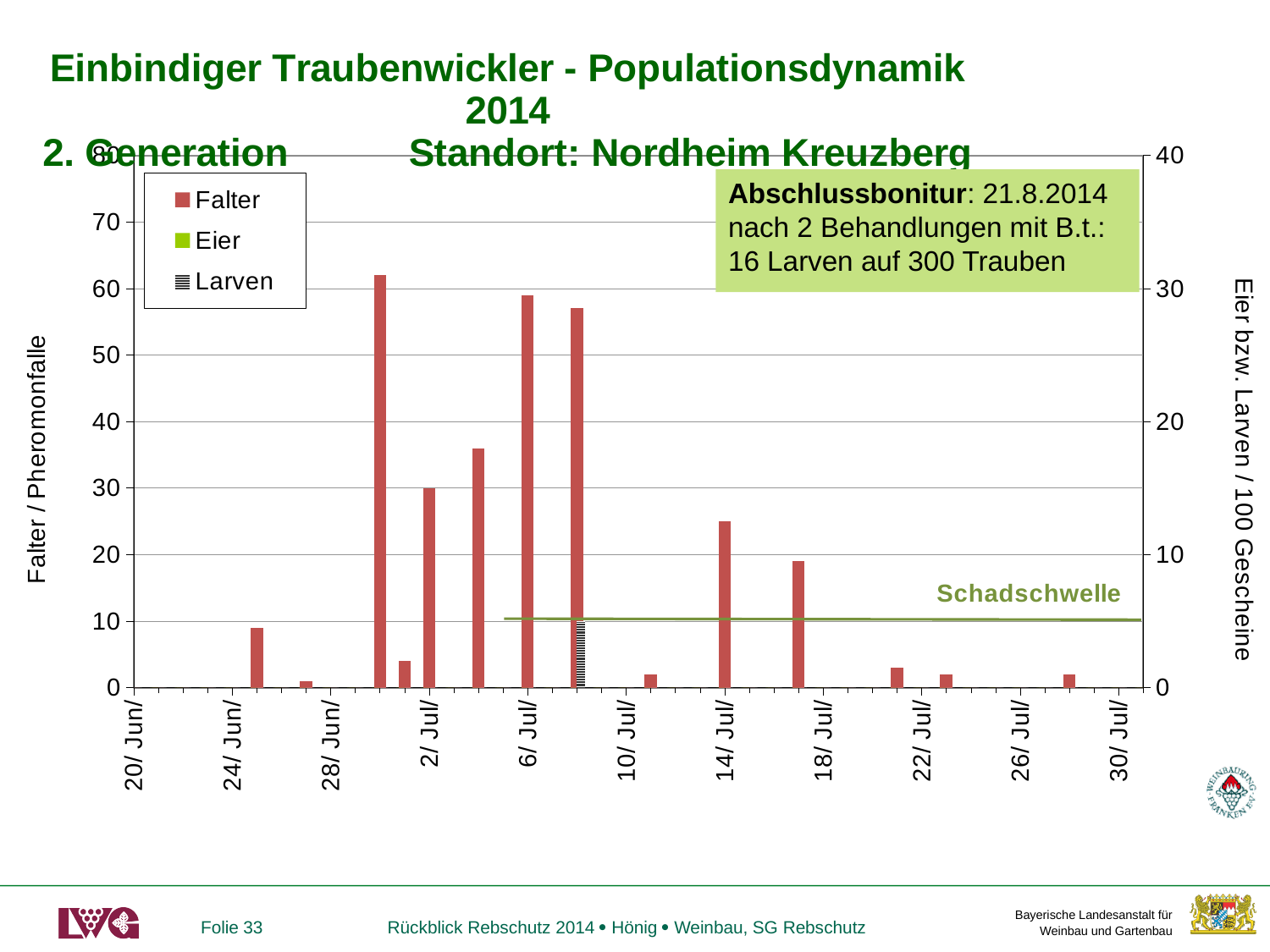
Which has the larger Falter value, 2/ Jul or 24/ Jun? 2/ Jul Is the Falter value on 24/ Jun greater or less than 20? less How many Larven bars are plotted on the chart? 1 Which series are listed in the legend? Falter, Eier, Larven Which has the larger Falter value, 6/ Jul or 14/ Jul? 6/ Jul Is the Falter value on 2/ Jul greater or less than 40? less Is the Falter value on 14/ Jul greater or less than 20? greater Do the Falter values rise or fall from 6/ Jul to 14/ Jul? fall What is the title of the left vertical axis? Falter / Pheromonfalle How many series does the legend list? 3 What kind of chart is shown on the slide? bar chart